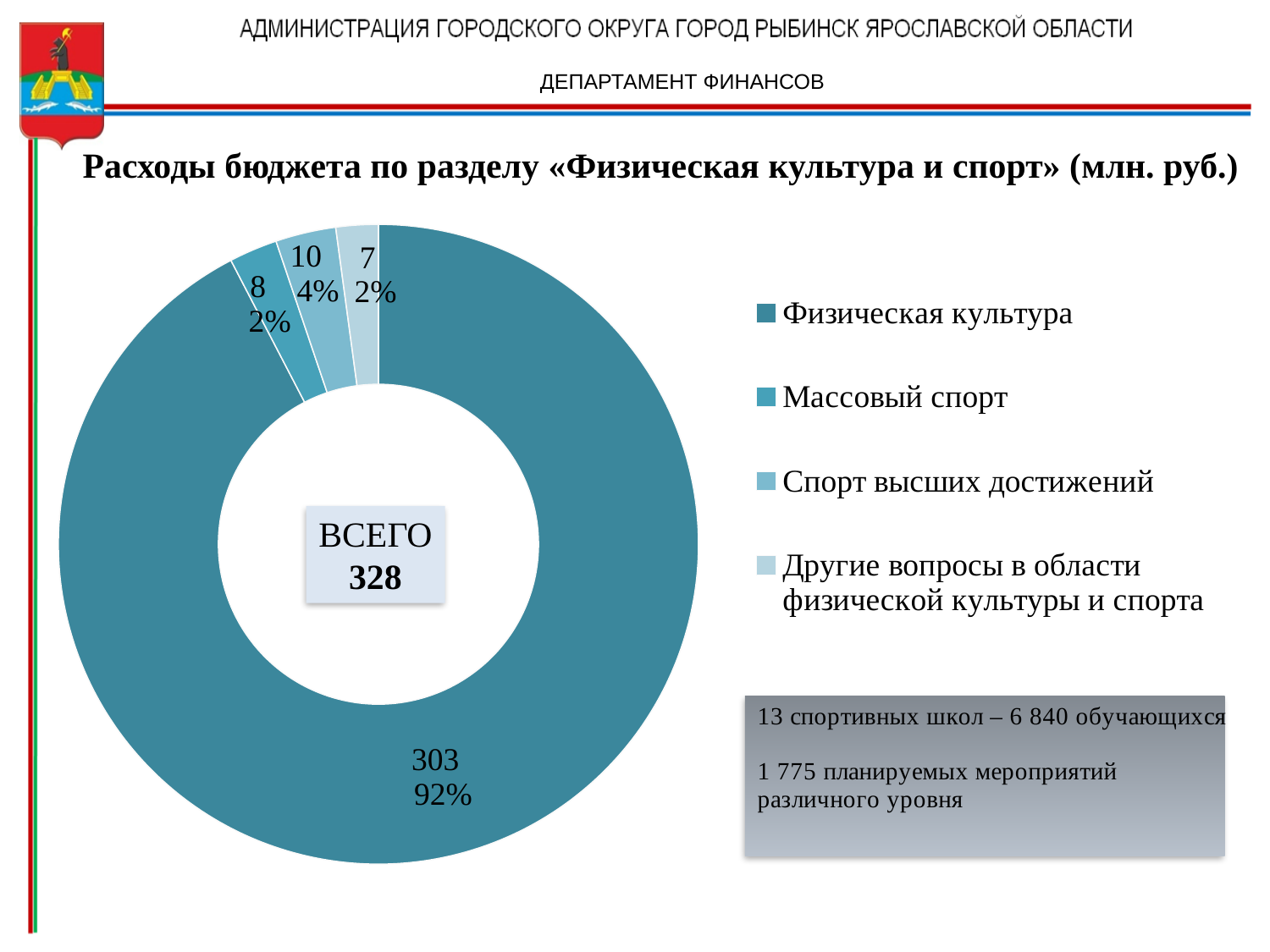
What is the difference between the values for Физическая культура and Спорт высших достижений? 293 How many categories are shown in the chart? 4 What is the value for Физическая культура? 303 Which category has the highest value? Физическая культура Which category has the lowest value? Другие вопросы в области физической культуры и спорта Which is larger, the value for Спорт высших достижений or the value for Массовый спорт? Спорт высших достижений What is the value for Другие вопросы в области физической культуры и спорта? 7 What share of the chart does Спорт высших достижений represent? 4% What kind of chart is shown on the slide? Pie (doughnut) chart What is the value for Массовый спорт? 8 What share of the chart does Физическая культура represent? 92% What is the value for Спорт высших достижений? 10